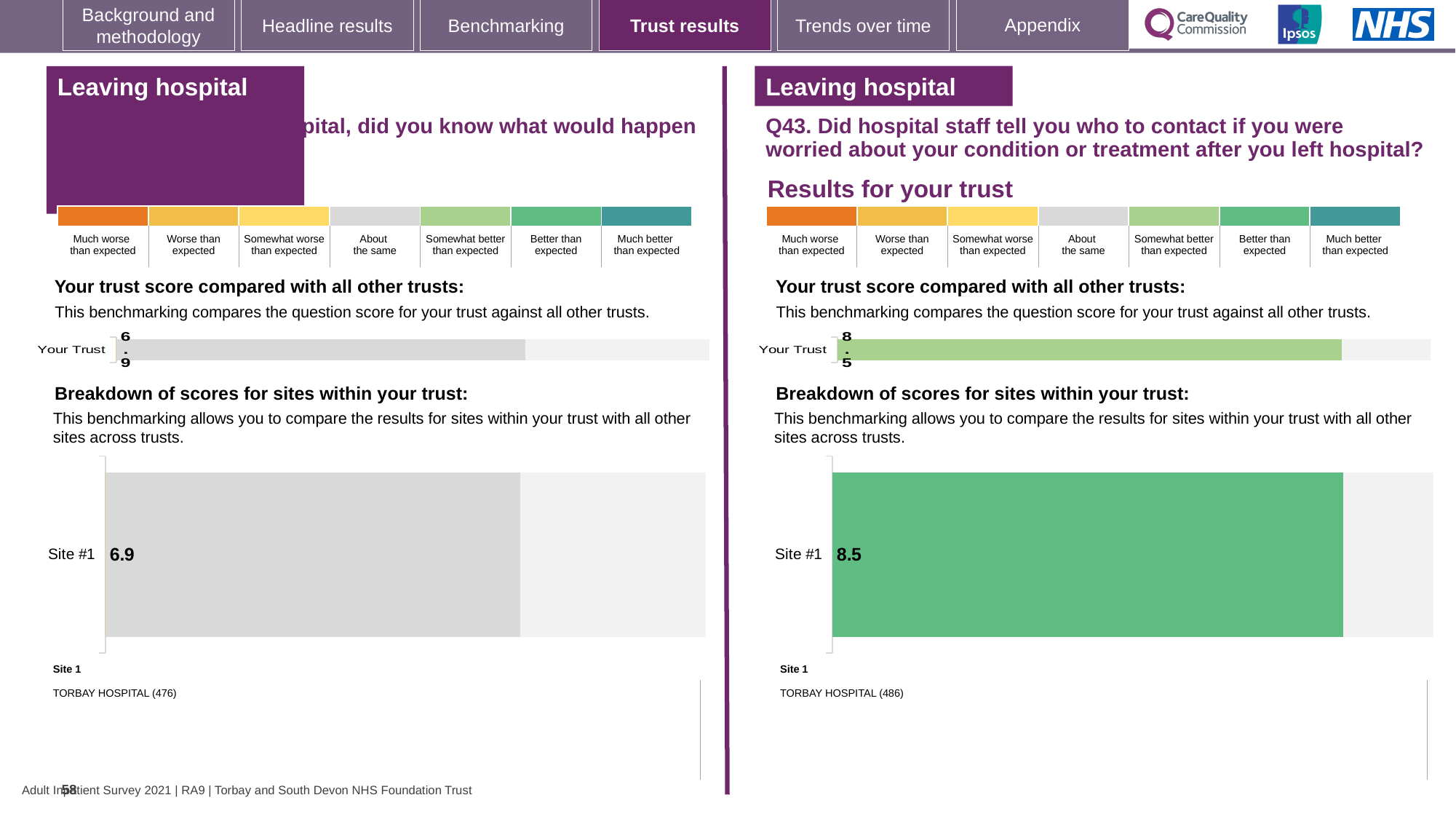
Which site name is listed as Site 1 on the left-hand chart? TORBAY HOSPITAL (476) On the left-hand site breakdown chart, what is the score for Site #1? 6.9 What kind of chart is used to show the Site #1 score on the right-hand side for Q43? Bar chart On the right-hand chart for Q43, which benchmark category does the colour of the Site #1 bar correspond to? Better than expected On the right-hand site breakdown chart for Q43, what is the score for Site #1? 8.5 What is the difference between the Site #1 score on the right-hand chart for Q43 and the Site #1 score on the left-hand chart? 1.6 How many sites are shown in the site breakdown chart on the right-hand side for Q43? 1 Which is larger: the Site #1 score on the left-hand chart or the Site #1 score on the right-hand chart for Q43? Right-hand chart (Q43) On the right-hand chart for Q43, what is the score shown for Your Trust? 8.5 How many sites are shown in the site breakdown chart on the left-hand side? 1 On the left-hand chart, what is the score shown for Your Trust? 6.9